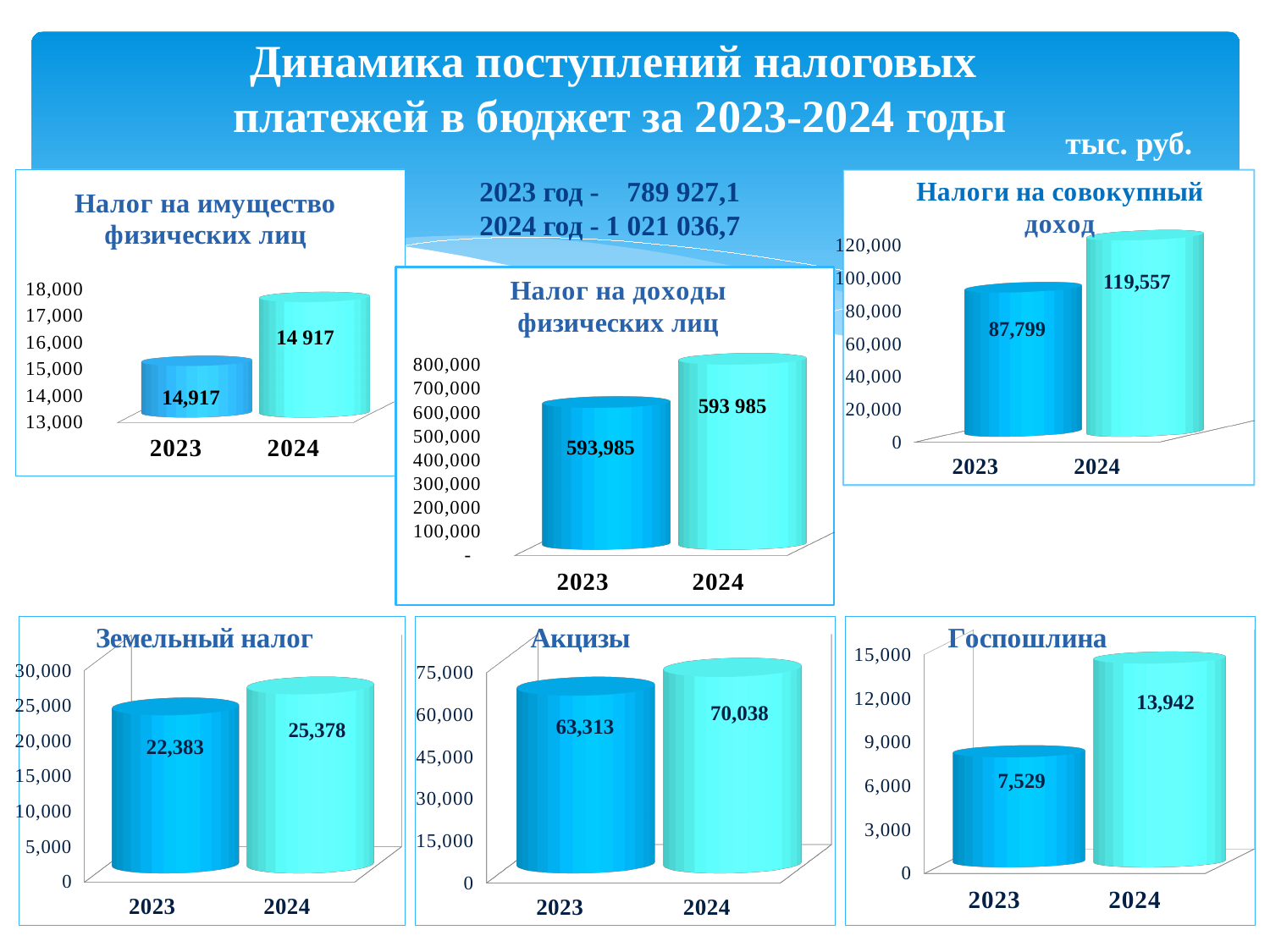
In the chart titled 'Госпошлина', what is the difference between the 2024 and 2023 values? 6,413 In the chart titled 'Земельный налог', what is the value for 2023? 22,383 In the chart titled 'Акцизы', what is the value for 2024? 70,038 In the chart titled 'Земельный налог', what is the difference between the 2024 and 2023 values? 2,995 In the chart titled 'Налоги на совокупный доход', what is the value for 2024? 119,557 In the chart titled 'Госпошлина', what is the value for 2023? 7,529 How many charts are shown on the slide? 6 In the chart titled 'Налоги на совокупный доход', what is the value for 2023? 87,799 In the chart titled 'Налоги на совокупный доход', what is the difference between the 2024 and 2023 values? 31,758 In the chart titled 'Госпошлина', is the value for 2024 greater or less than 12,000? greater In the chart titled 'Акцизы', which year has the higher value, 2023 or 2024? 2024 What kind of chart is the one titled 'Земельный налог'? bar chart